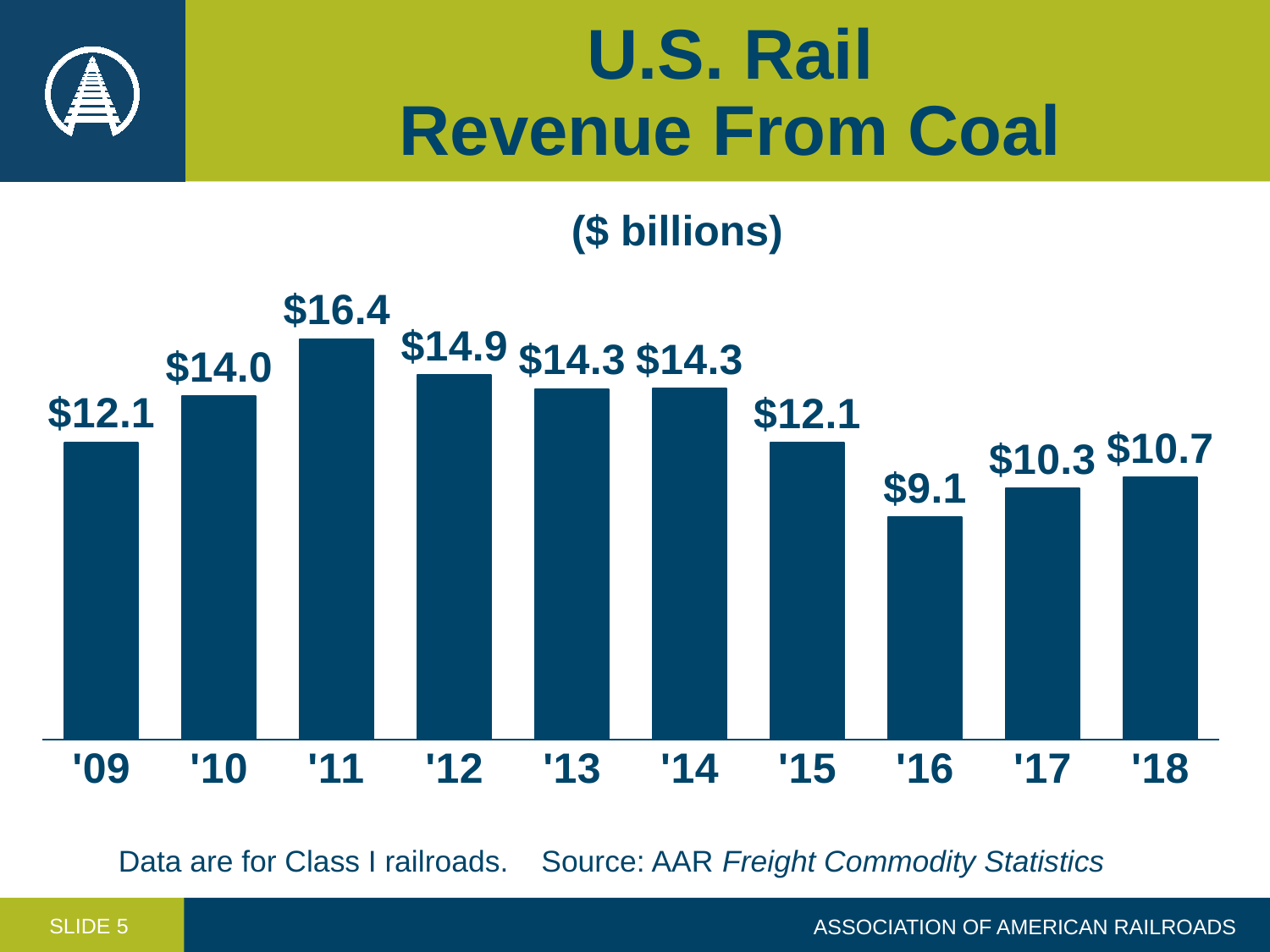
What is the U.S. rail revenue from coal in '16? $9.1 What is the difference between the revenue in '18 and the revenue in '17? $0.4 What is the U.S. rail revenue from coal in '11? $16.4 Which year has the lowest rail revenue from coal? '16 Which year has higher rail revenue from coal, '10 or '12? '12 How many years are shown on the chart? 10 What is the difference between the revenue in '11 and the revenue in '16? $7.3 What unit is the chart's data expressed in? $ billions What is the U.S. rail revenue from coal in '18? $10.7 Do the values rise or fall from '14 to '16? Fall What kind of chart is shown on the slide? Bar chart Which year has the highest rail revenue from coal? '11